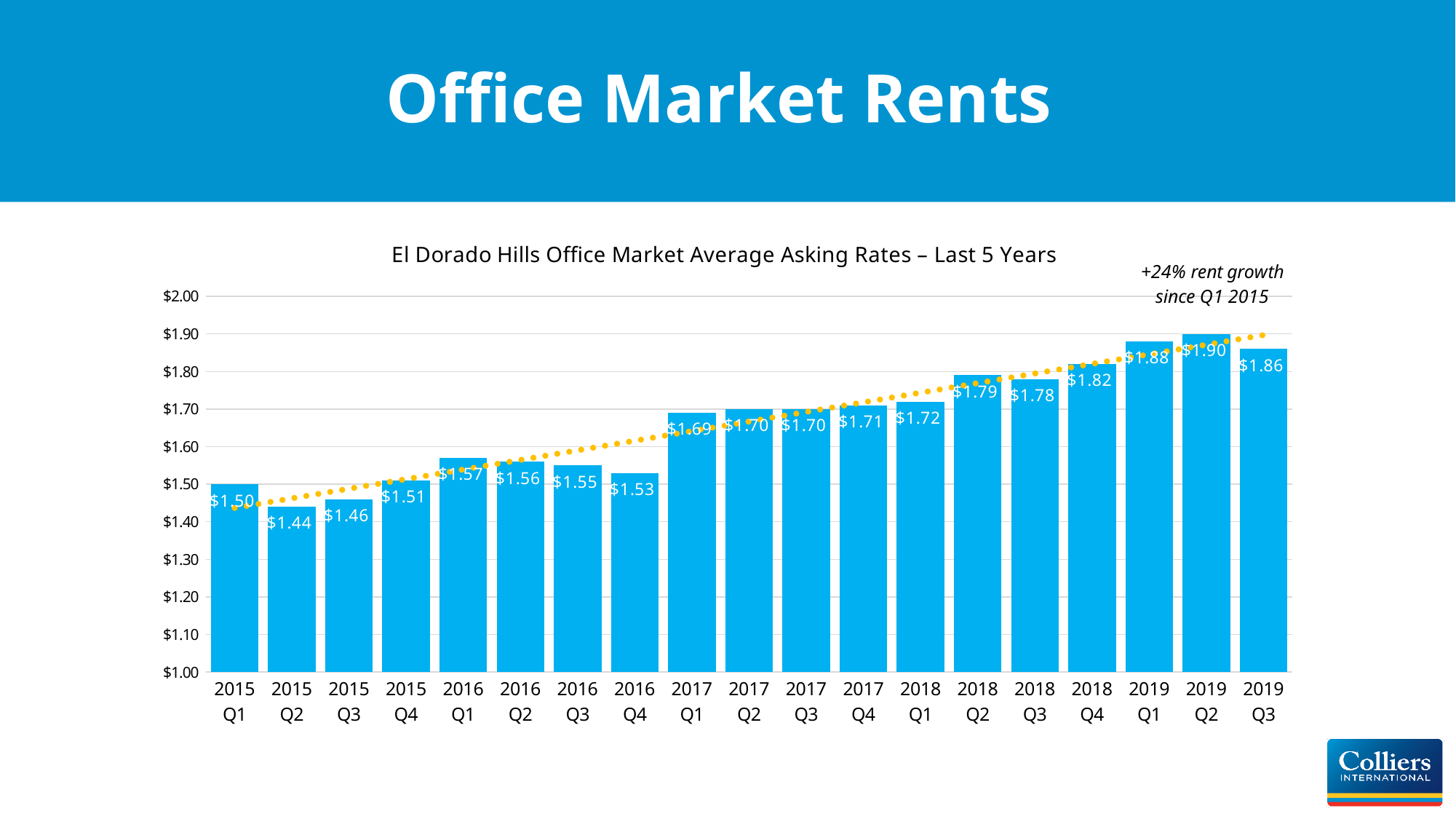
Is the value for 2016 Q4 greater or less than $1.60? less What kind of chart is shown on the slide? bar chart Which quarter has the highest average asking rate? 2019 Q2 What is the difference between the asking rate in 2019 Q2 and 2015 Q1? $0.40 What is the average asking rate for 2015 Q1? $1.50 How many quarters are plotted on the chart? 19 Which is larger, the asking rate for 2018 Q2 or 2018 Q3? 2018 Q2 Do the asking rates generally rise or fall from 2015 Q1 to 2019 Q3? rise What rent growth since Q1 2015 is noted on the chart? +24% Which quarter has the lowest average asking rate? 2015 Q2 What is the average asking rate for 2019 Q3? $1.86 What is the average asking rate for 2017 Q4? $1.71